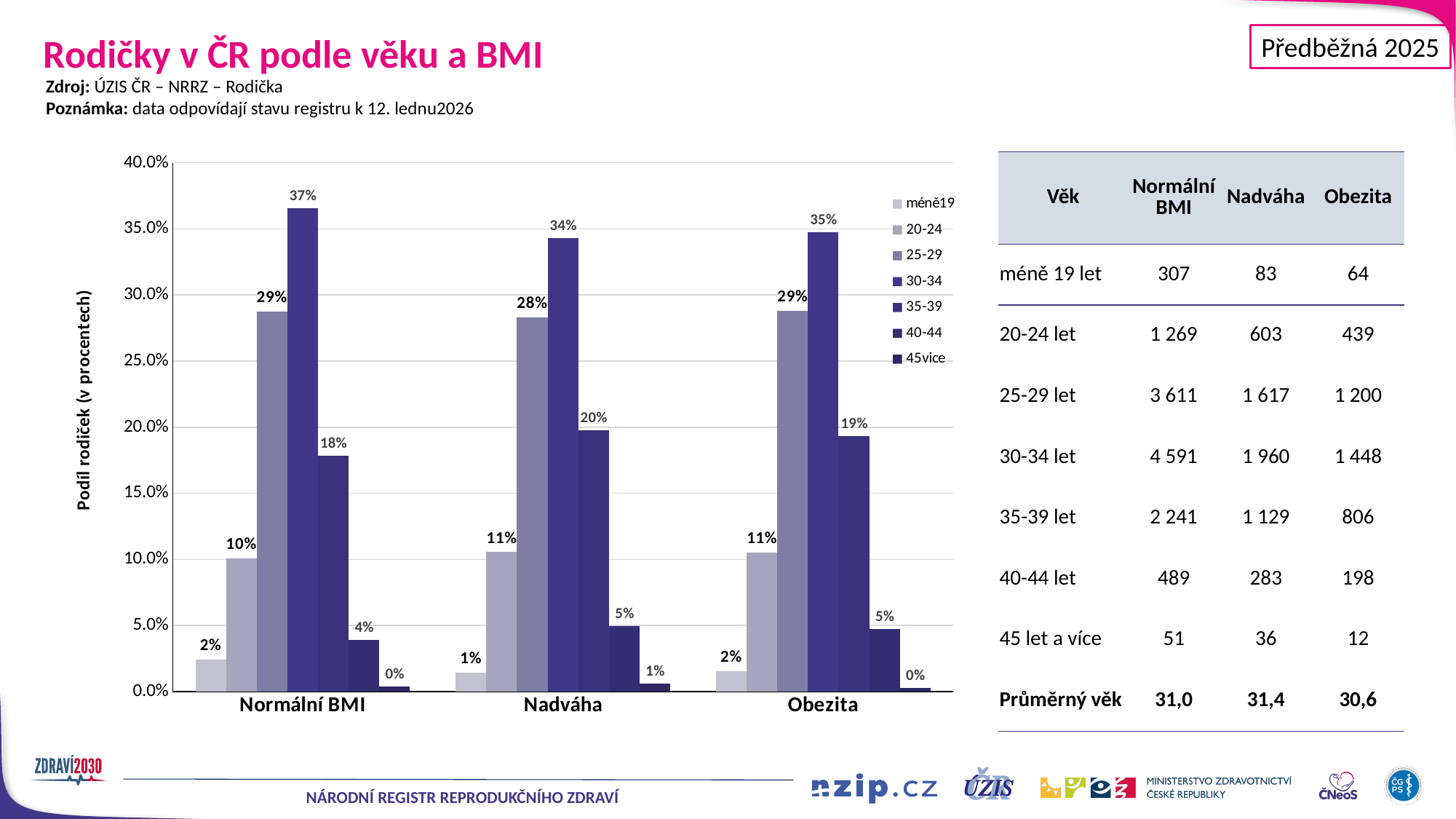
Is the value for the 35-39 age group in the Normální BMI category greater or less than 20.0%? less How many series does the chart legend list? 7 What type of chart is shown on the slide? bar chart Which age group has the lowest share in the Normální BMI category? 45více What is the value for the 25-29 age group in the Obezita category? 29% What is the difference between the 30-34 value and the 25-29 value in the Nadváha category? 6% What is the value for the 35-39 age group in the Nadváha category? 20% Which is larger: the 30-34 value for Normální BMI or the 30-34 value for Nadváha? Normální BMI Which age group has the highest share in the Obezita category? 30-34 What is the value for the 30-34 age group in the Normální BMI category? 37% How many BMI categories are shown on the x axis of the chart? 3 What is the label of the y axis of the chart? Podíl rodiček (v procentech)